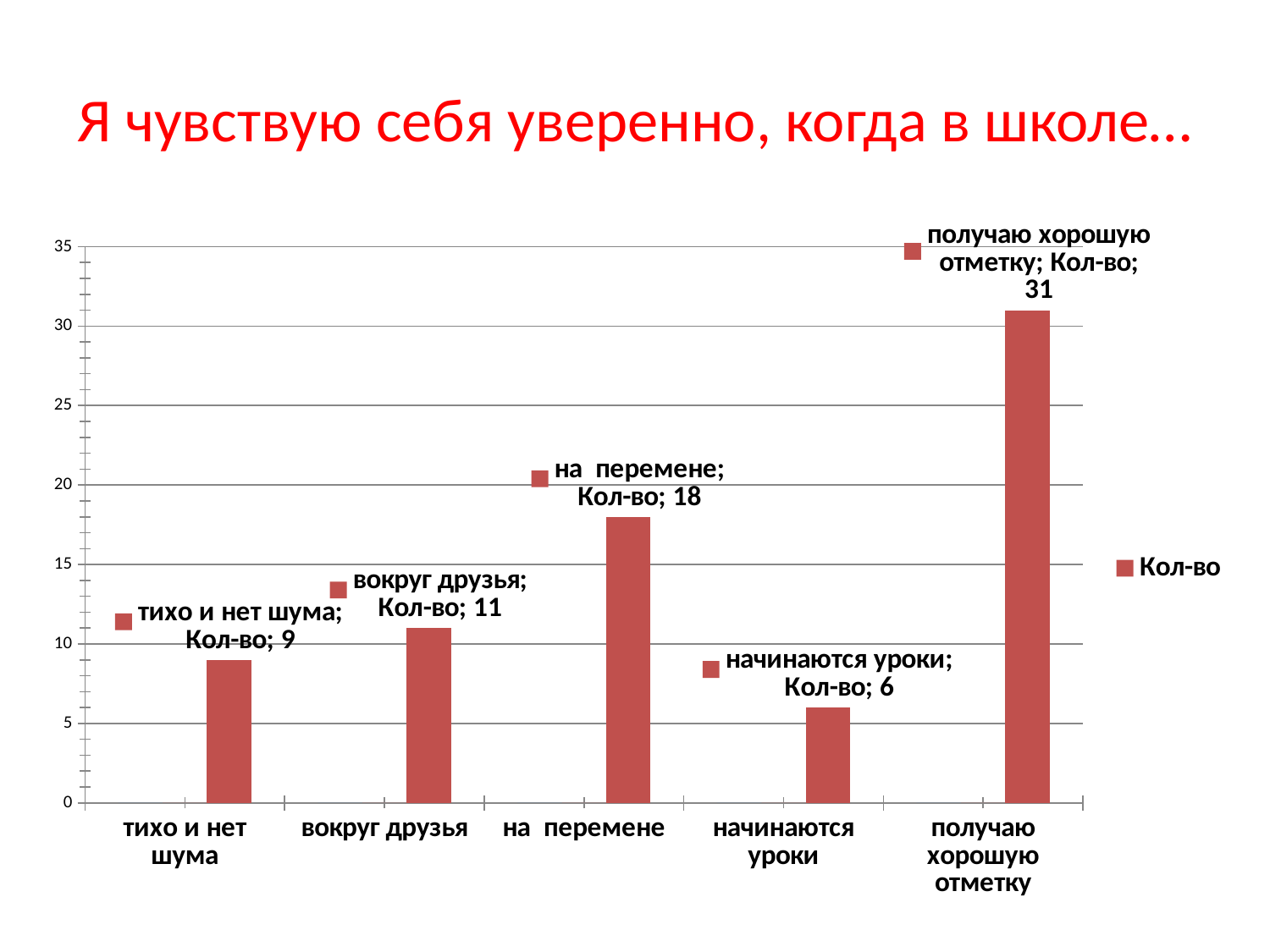
Which is larger, the value for "вокруг друзья" or the value for "тихо и нет шума"? вокруг друзья What is the value for "на перемене"? 18 What kind of chart is shown on the slide? bar chart Is the value for "на перемене" greater or less than 20? less What is the value for "тихо и нет шума"? 9 How many categories are shown on the chart? 5 Which category has the highest value? получаю хорошую отметку What is the difference between the values for "вокруг друзья" and "начинаются уроки"? 5 What is the name of the series shown in the legend? Кол-во Which category has the lowest value? начинаются уроки What is the value for "получаю хорошую отметку"? 31 What is the difference between the values for "получаю хорошую отметку" and "на перемене"? 13